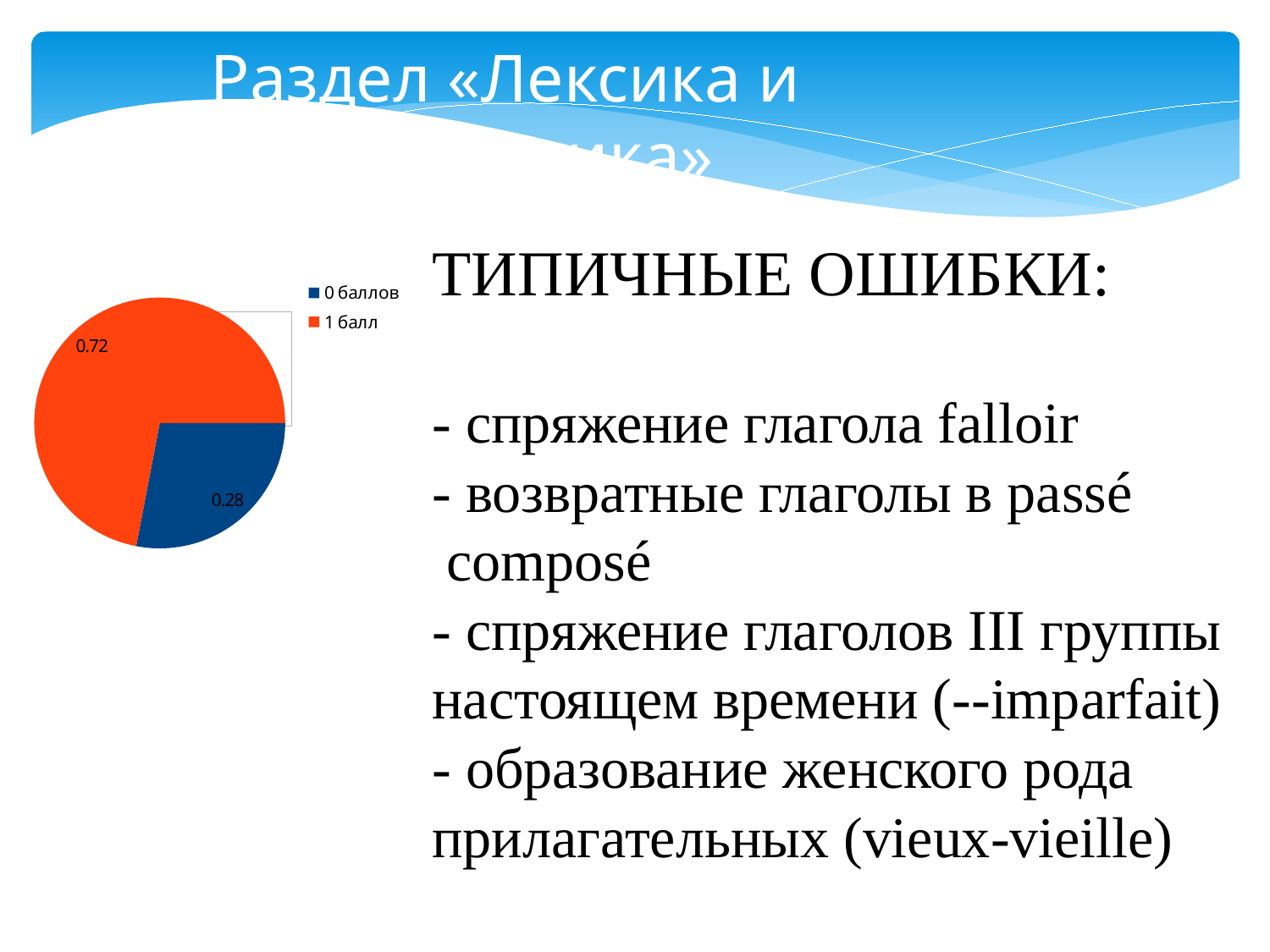
What is the value shown for the "0 баллов" slice of the pie chart? 0.28 What colour is the "1 балл" slice in the pie chart? orange What is the value shown for the "1 балл" slice of the pie chart? 0.72 How many entries does the legend of the pie chart list? 2 What kind of chart is shown on the slide? pie chart How many slices does the pie chart have? 2 Which is larger in the pie chart: "0 баллов" or "1 балл"? 1 балл Which slice of the pie chart is the smallest? 0 баллов Which slice of the pie chart is the largest? 1 балл What is the difference between the values for "1 балл" and "0 баллов" in the pie chart? 0.44 What colour is the "0 баллов" slice in the pie chart? blue